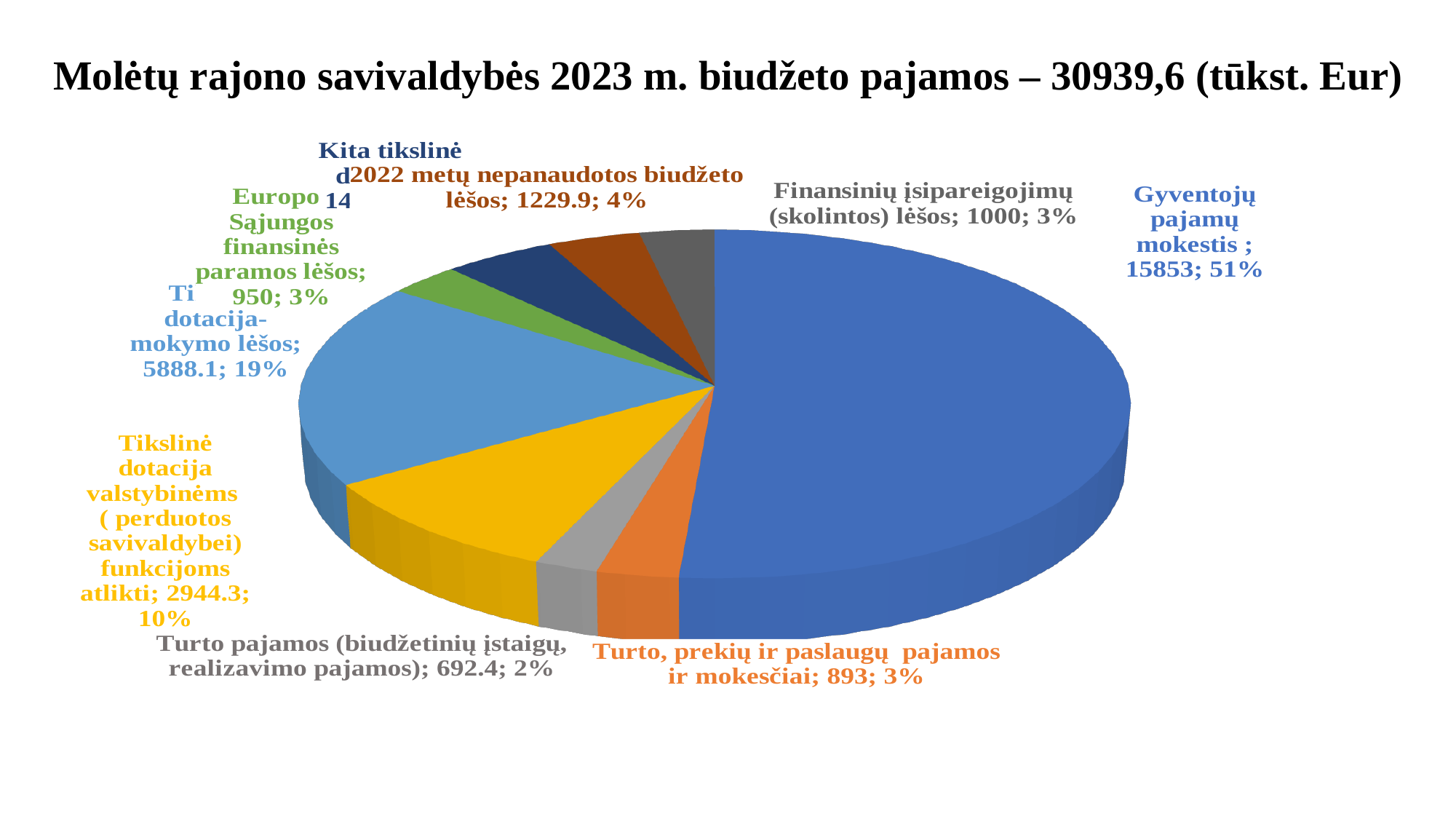
What kind of chart is shown on the slide? pie chart Which category has the largest slice of the pie? Gyventojų pajamų mokestis What is the difference between the value for Gyventojų pajamų mokestis and the value for dotacija-mokymo lėšos? 9964.9 What total budget revenue is stated in the chart title? 30939,6 (tūkst. Eur) What is the value for Gyventojų pajamų mokestis? 15853 What is the value for 2022 metų nepanaudotos biudžeto lėšos? 1229.9 What is the value for Turto, prekių ir paslaugų pajamos ir mokesčiai? 893 Which is larger: Finansinių įsipareigojimų (skolintos) lėšos or Europos Sąjungos finansinės paramos lėšos? Finansinių įsipareigojimų (skolintos) lėšos What share of the pie does Tikslinė dotacija valstybinėms (perduotos savivaldybei) funkcijoms atlikti represent? 10% Which category has the smallest slice of the pie? Turto pajamos (biudžetinių įstaigų realizavimo pajamos) How many slices does the pie chart have? 9 What share of the pie does Gyventojų pajamų mokestis represent? 51%